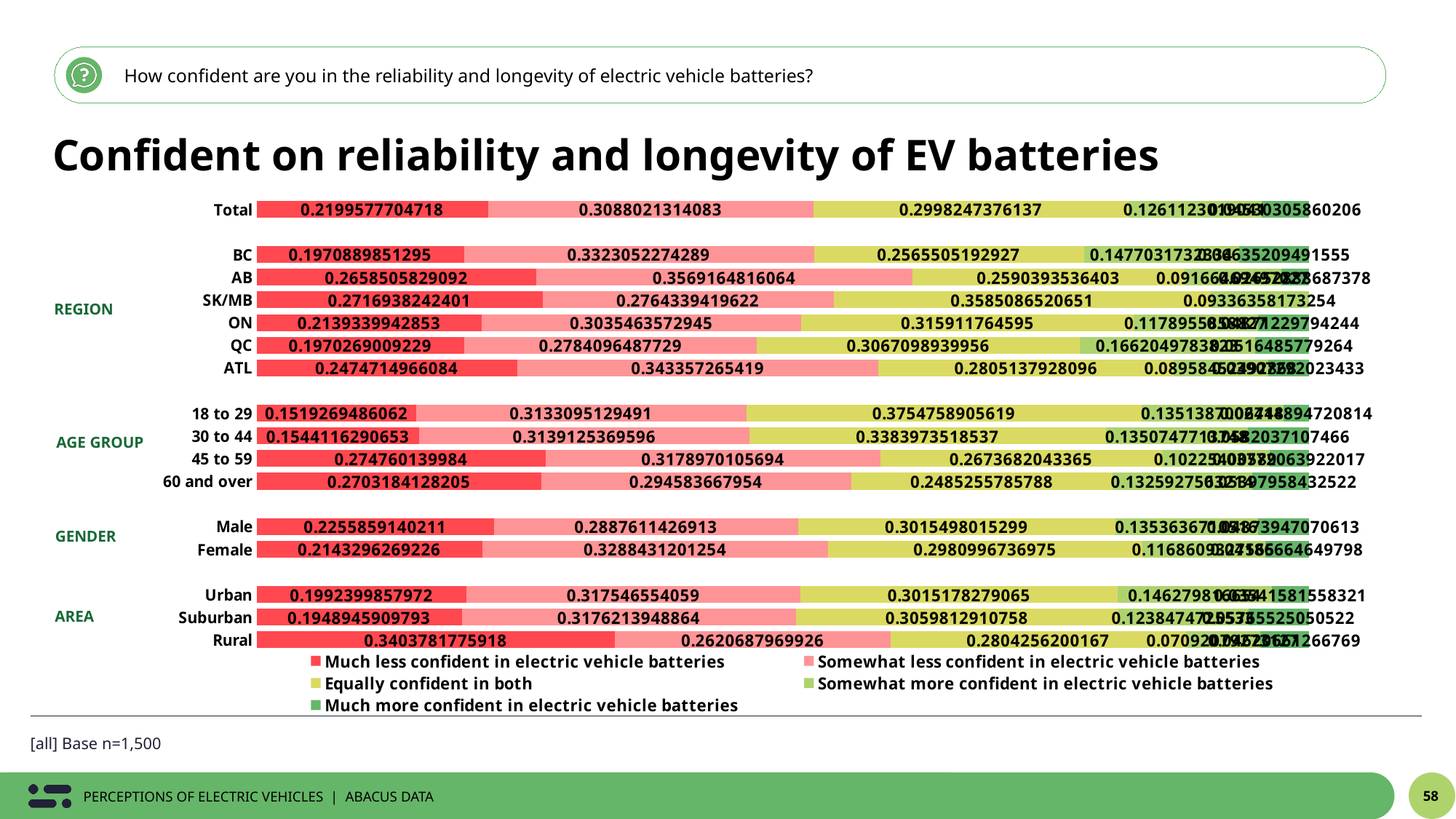
How many bars (categories) are plotted in the chart? 16 What is the value for 'Somewhat less confident in electric vehicle batteries' for AB? 0.3569164816064 What is the value for 'Much less confident in electric vehicle batteries' for Rural? 0.3403781775918 What is the value for 'Equally confident in both' for 18 to 29? 0.3754758905619 What kind of chart is shown on the slide? Stacked bar chart How many series does the legend list? 5 Which category has the highest value for 'Equally confident in both'? 18 to 29 What is the difference between the 'Much less confident in electric vehicle batteries' values for Rural and Total? 0.12042040712 Which category has the highest value for 'Much less confident in electric vehicle batteries'? Rural Which is larger for 'Somewhat less confident in electric vehicle batteries': AB or ATL? AB Which category has the lowest value for 'Much less confident in electric vehicle batteries'? 18 to 29 What is the value for 'Much less confident in electric vehicle batteries' for the Total bar? 0.2199577704718